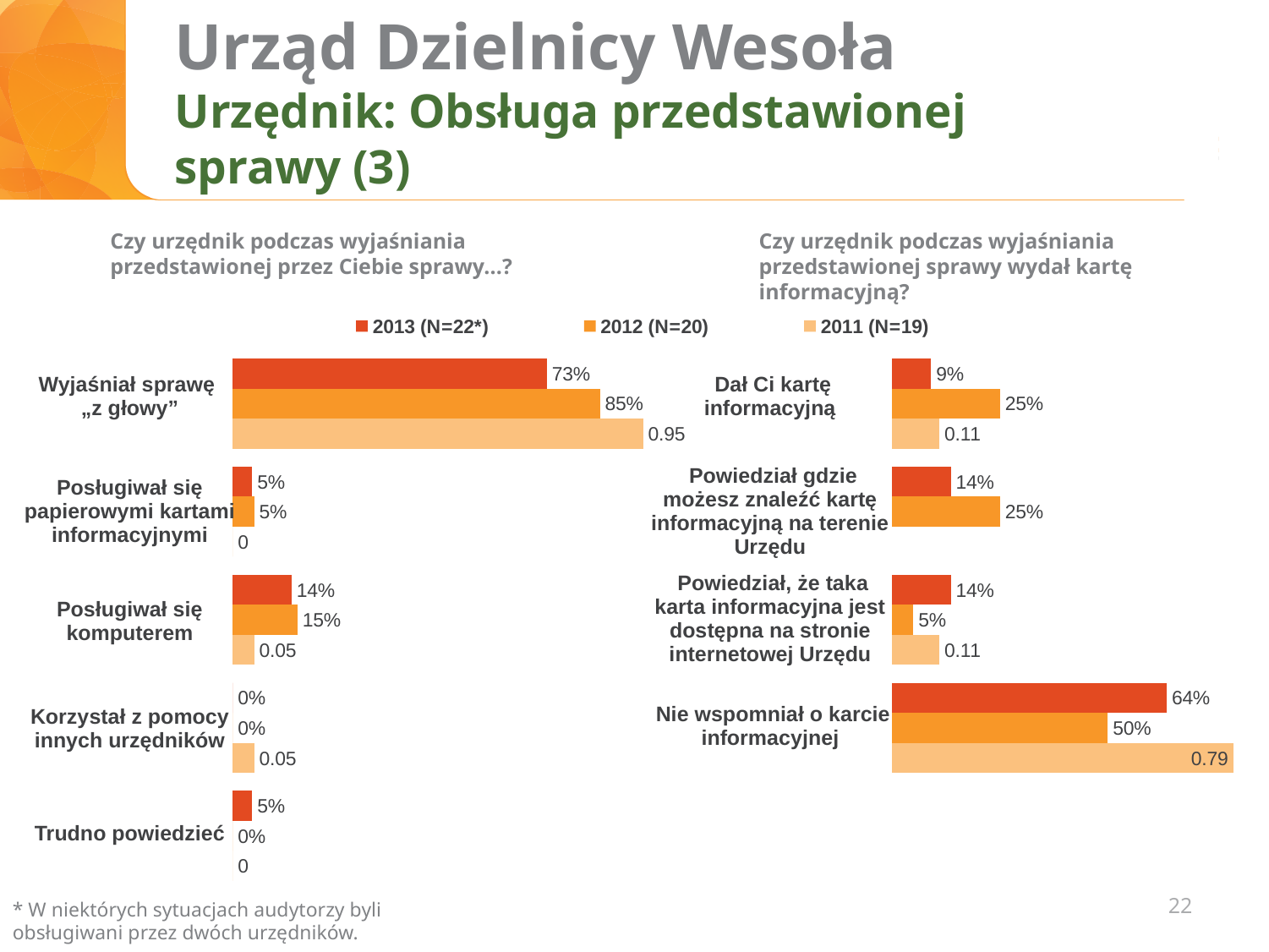
In the right chart ("Czy urzędnik podczas wyjaśniania przedstawionej sprawy wydał kartę informacyjną?"), what is the 2013 value for "Nie wspomniał o karcie informacyjnej"? 64% In the right chart, which is larger for "Dał Ci kartę informacyjną": the 2013 value or the 2012 value? 2012 How many categories does the left chart show? 5 What sample size (N) does the legend give for 2013? N=22* In the left chart, what is the 2011 value for "Wyjaśniał sprawę „z głowy”"? 0.95 What type of chart is used on this slide? Bar chart How many series does the legend list? 3 In the right chart, what is the 2011 value for "Nie wspomniał o karcie informacyjnej"? 0.79 In the left chart, what is the difference between the 2012 and 2013 values for "Wyjaśniał sprawę „z głowy”"? 12 percentage points In the left chart, which category has the highest 2012 value? Wyjaśniał sprawę „z głowy” In the left chart ("Czy urzędnik podczas wyjaśniania przedstawionej przez Ciebie sprawy...?"), what is the 2013 value for "Wyjaśniał sprawę „z głowy”"? 73% In the left chart, what is the 2012 value for "Posługiwał się komputerem"? 15%